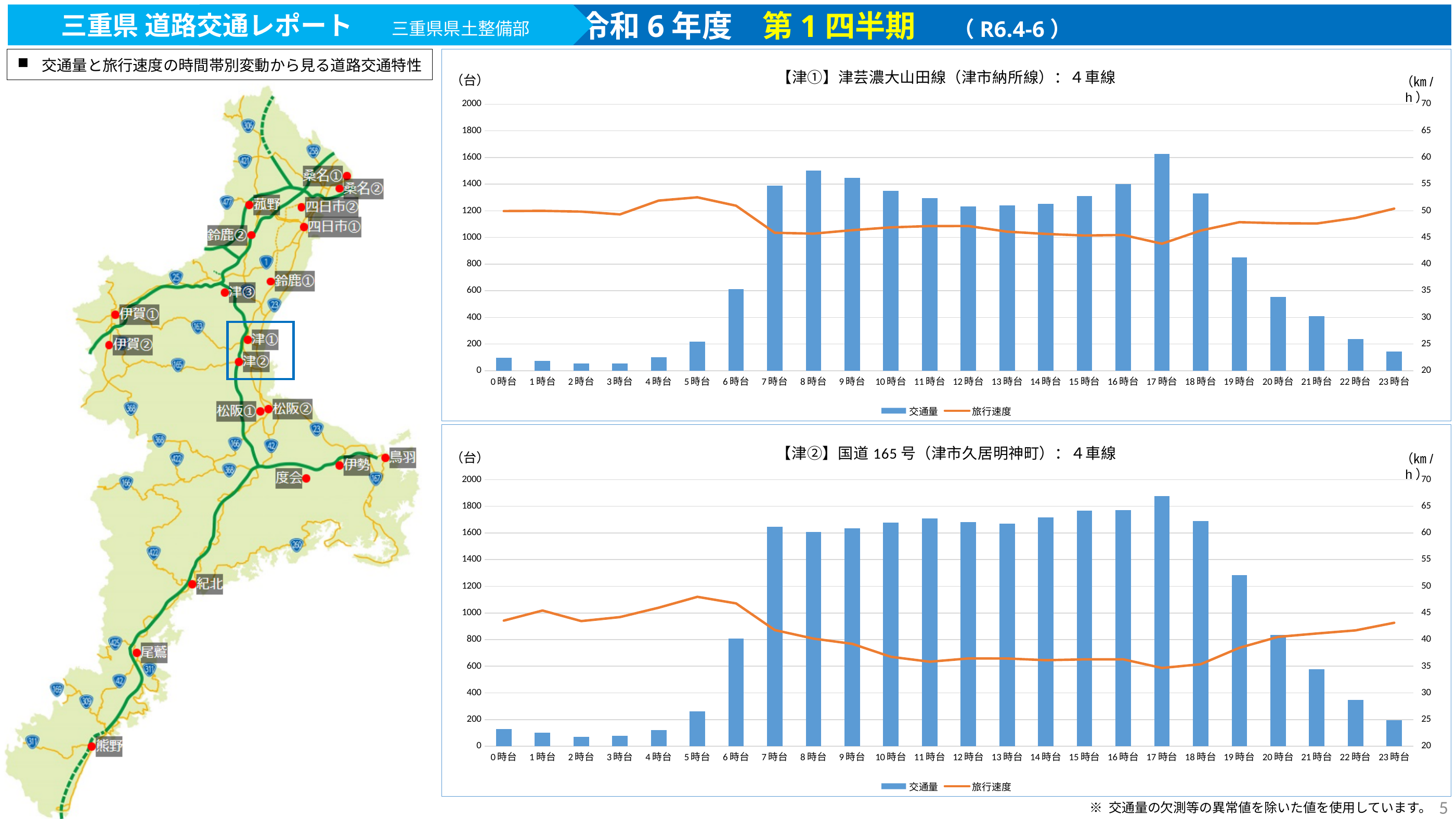
In the 【津①】 chart, which hour has the highest traffic volume (交通量) bar? 17時台 In the 【津①】 chart, which hour has the larger traffic volume, 18時台 or 19時台? 18時台 In the 【津②】 chart, is the traffic volume for 21時台 greater or less than 800? less How many series does the legend of the 【津②】 chart list? 2 In the 【津②】 chart, is the travel speed (旅行速度) at 17時台 greater or less than 40 km/h? less In the 【津②】 chart, which hour has the larger traffic volume, 15時台 or 8時台? 15時台 In the 【津②】 chart, which hour has the highest traffic volume (交通量) bar? 17時台 In the 【津①】 chart, do the traffic volume bars rise or fall from 17時台 to 23時台? fall How many hourly categories are shown on the x axis of the 【津①】 chart? 24 In the 【津①】 chart, is the traffic volume for 7時台 greater or less than 1200? greater